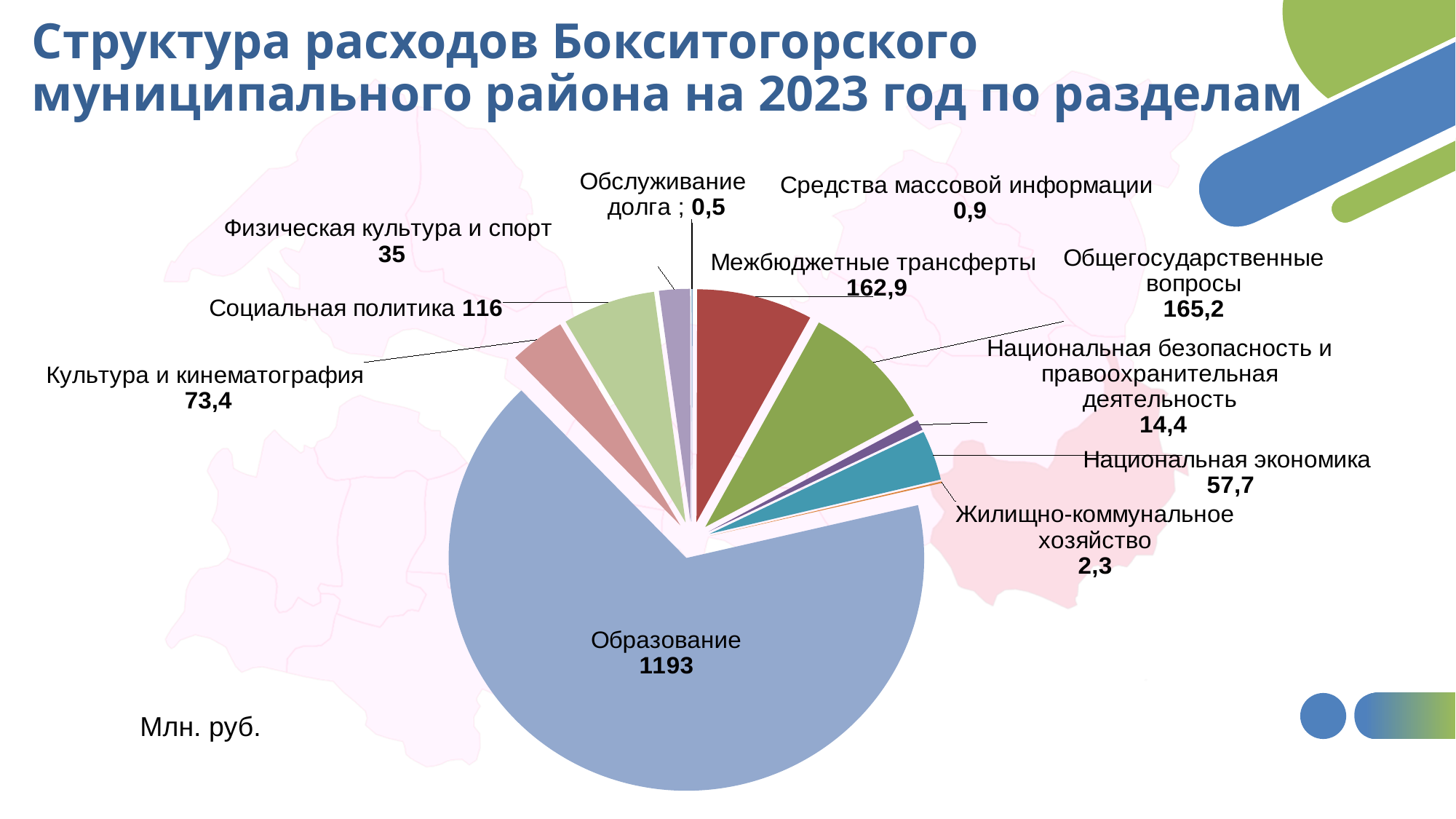
Which category has the largest value? Образование What unit is indicated for the values in the chart? Млн. руб. What is the value for Культура и кинематография? 73,4 What is the difference between Образование and Социальная политика? 1077 Which category has the smallest value? Обслуживание долга Which is larger, Национальная экономика or Физическая культура и спорт? Национальная экономика What is the value for Национальная безопасность и правоохранительная деятельность? 14,4 What type of chart is shown on the slide? pie chart How many categories are shown in the pie chart? 11 What is the value for Общегосударственные вопросы? 165,2 What is the value for Образование? 1193 What is the difference between Общегосударственные вопросы and Межбюджетные трансферты? 2,3